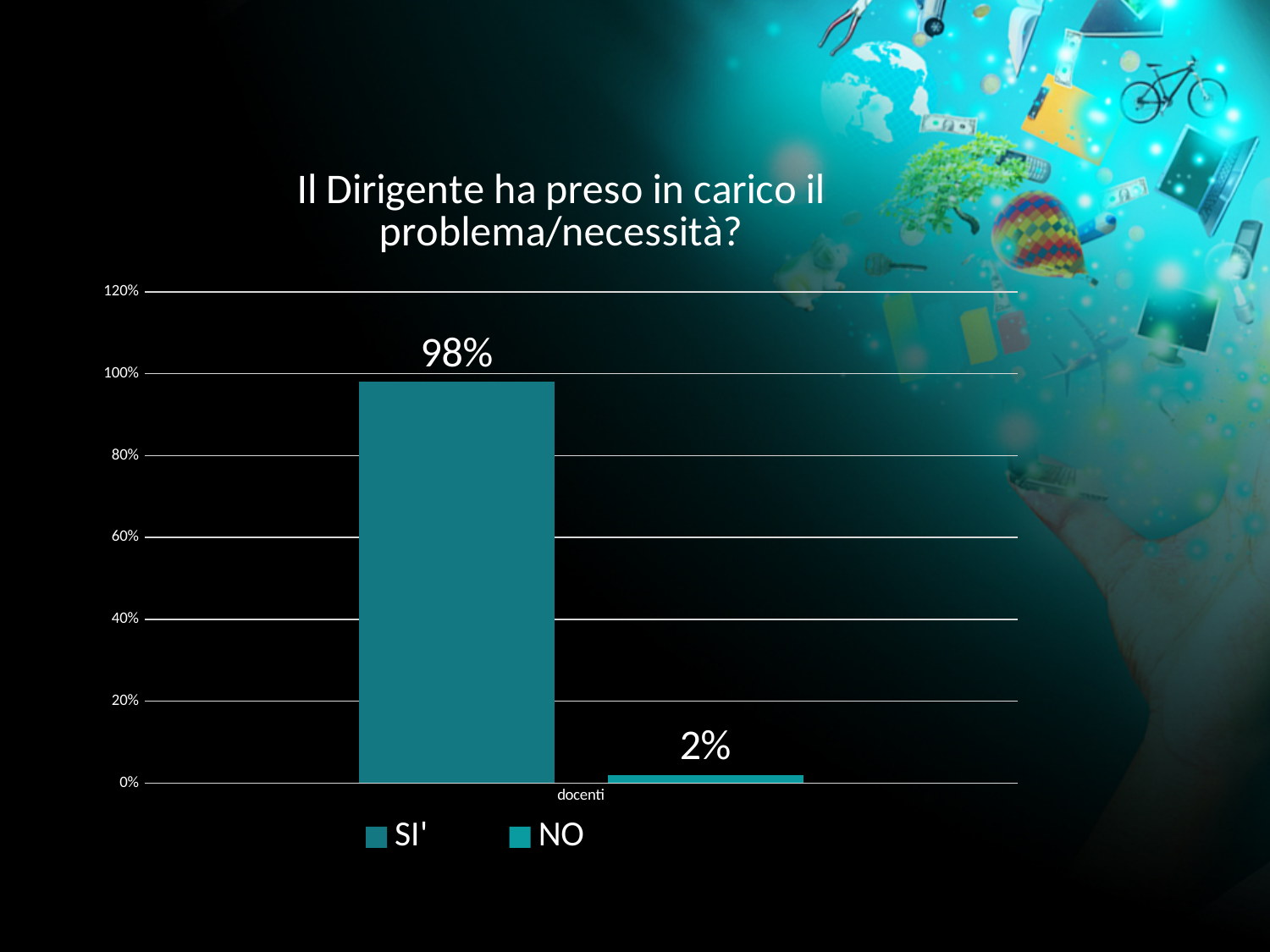
What is the value for NO in the chart? 2% Is the value for SI' larger or smaller than the value for NO? larger What kind of chart is shown on the slide? bar chart Which series has the lowest value in the chart? NO What is the title of the chart? Il Dirigente ha preso in carico il problema/necessità? What is the difference between the SI' value and the NO value? 96% Which series has the highest value, SI' or NO? SI' Is the value for SI' greater or less than 80%? greater What is the value for SI' in the chart? 98% How many series does the legend list? 2 Is the value for NO greater or less than 20%? less What is the category label shown on the x axis? docenti